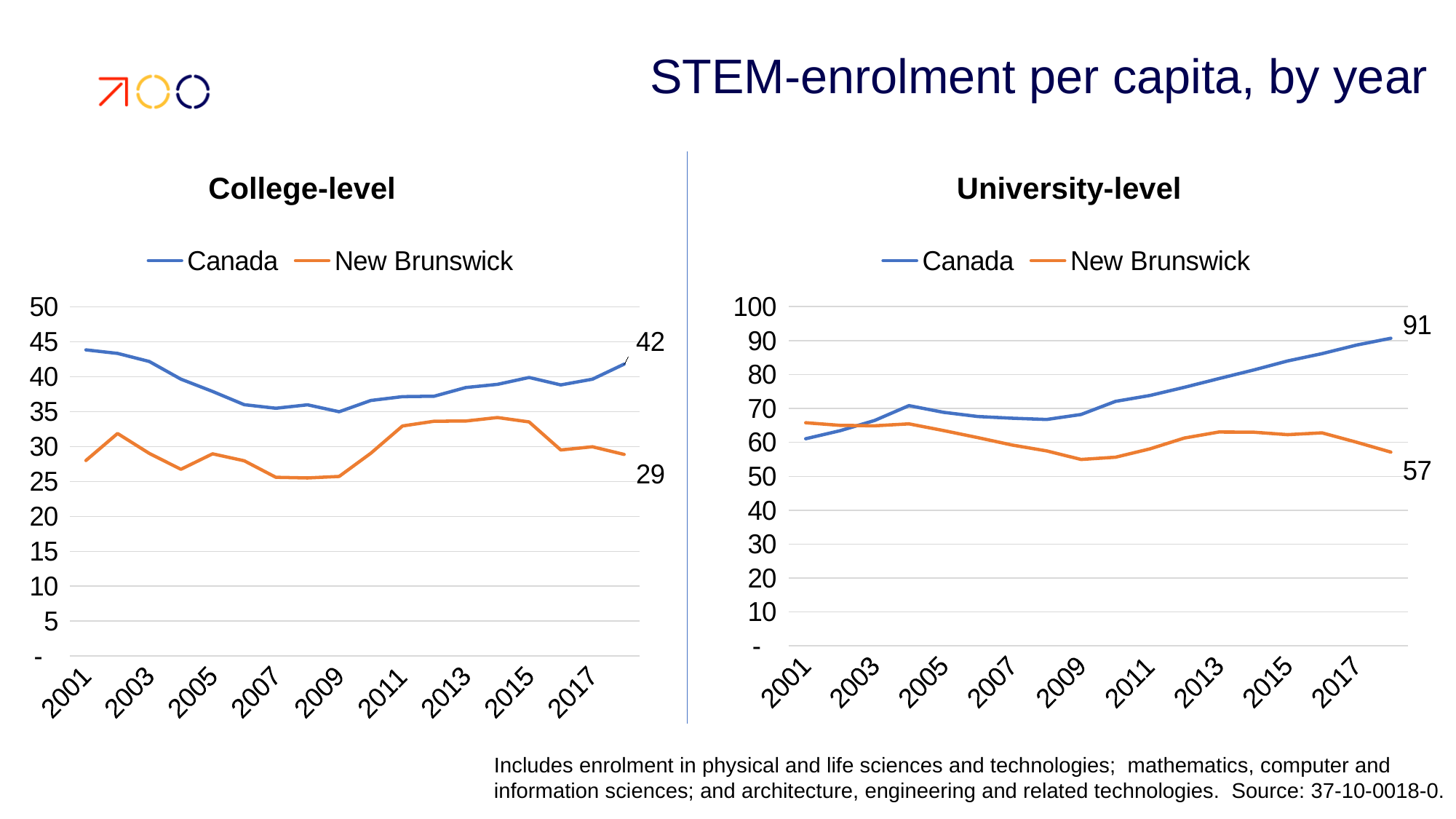
On the University-level chart, does the Canada line rise or fall from 2009 to the end of the series? rises On the College-level chart, what is the data label shown at the end of the New Brunswick line? 29 On the University-level chart, which series is higher in 2017, Canada or New Brunswick? Canada On the University-level chart, what is the difference between the final labelled values for Canada and New Brunswick? 34 How many series does the legend of the University-level chart list? 2 What kind of chart is the College-level chart? Line chart On the College-level chart, what is the difference between the final labelled values for Canada and New Brunswick? 13 On the University-level chart, what is the data label shown at the end of the Canada line? 91 On the University-level chart, is the value for New Brunswick in 2009 greater or less than 60? less On the College-level chart, is the value for Canada in 2001 greater or less than 40? greater On the University-level chart, what is the data label shown at the end of the New Brunswick line? 57 On the College-level chart, what is the data label shown at the end of the Canada line? 42